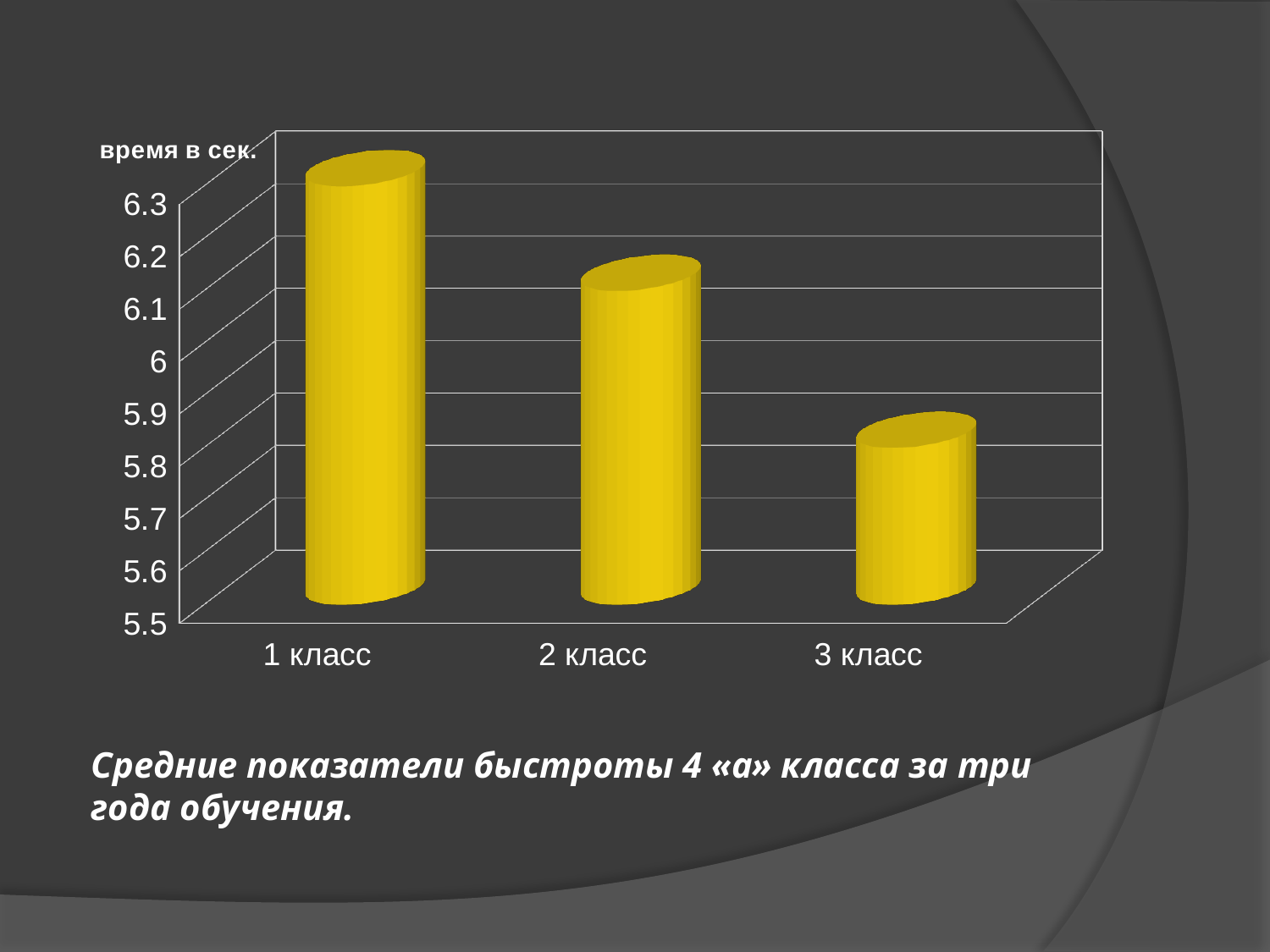
Is the value for 3 класс greater or less than 6? less Do the values rise or fall from 1 класс to 3 класс? fall What kind of chart is shown on the slide? bar chart What label is shown on the vertical axis of the chart? время в сек. Which is larger, the value for 2 класс or the value for 3 класс? 2 класс Is the value for 1 класс greater or less than 6? greater Is the value for 2 класс greater or less than 6? greater Which category has the highest value? 1 класс How many categories are plotted on the chart? 3 What is the lowest value shown on the vertical axis? 5.5 Which category has the lowest value? 3 класс Which is larger, the value for 1 класс or the value for 3 класс? 1 класс